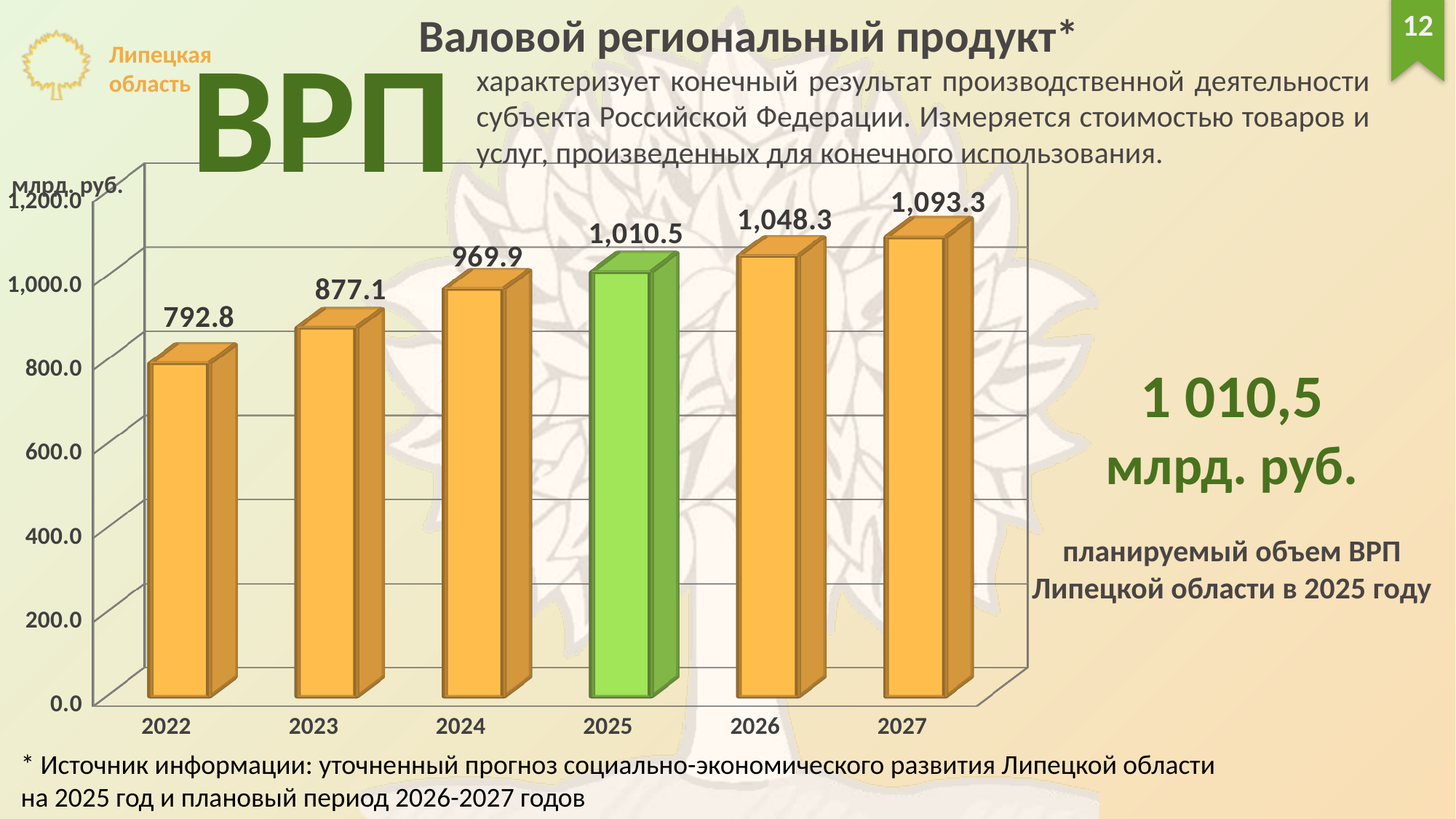
What is the value shown for 2026? 1,048.3 Is the value for 2024 greater or less than 1,000.0? less What kind of chart is shown? bar chart What is the difference between the values for 2025 and 2024? 40.6 Which year has the lowest value? 2022 What is the difference between the values for 2027 and 2022? 300.5 Which year has the highest value? 2027 What is the value shown for 2025? 1,010.5 What is the value shown for 2022? 792.8 Which is larger, the value for 2023 or the value for 2024? 2024 Do the values rise or fall from 2022 to 2027? rise How many years are shown on the x axis? 6